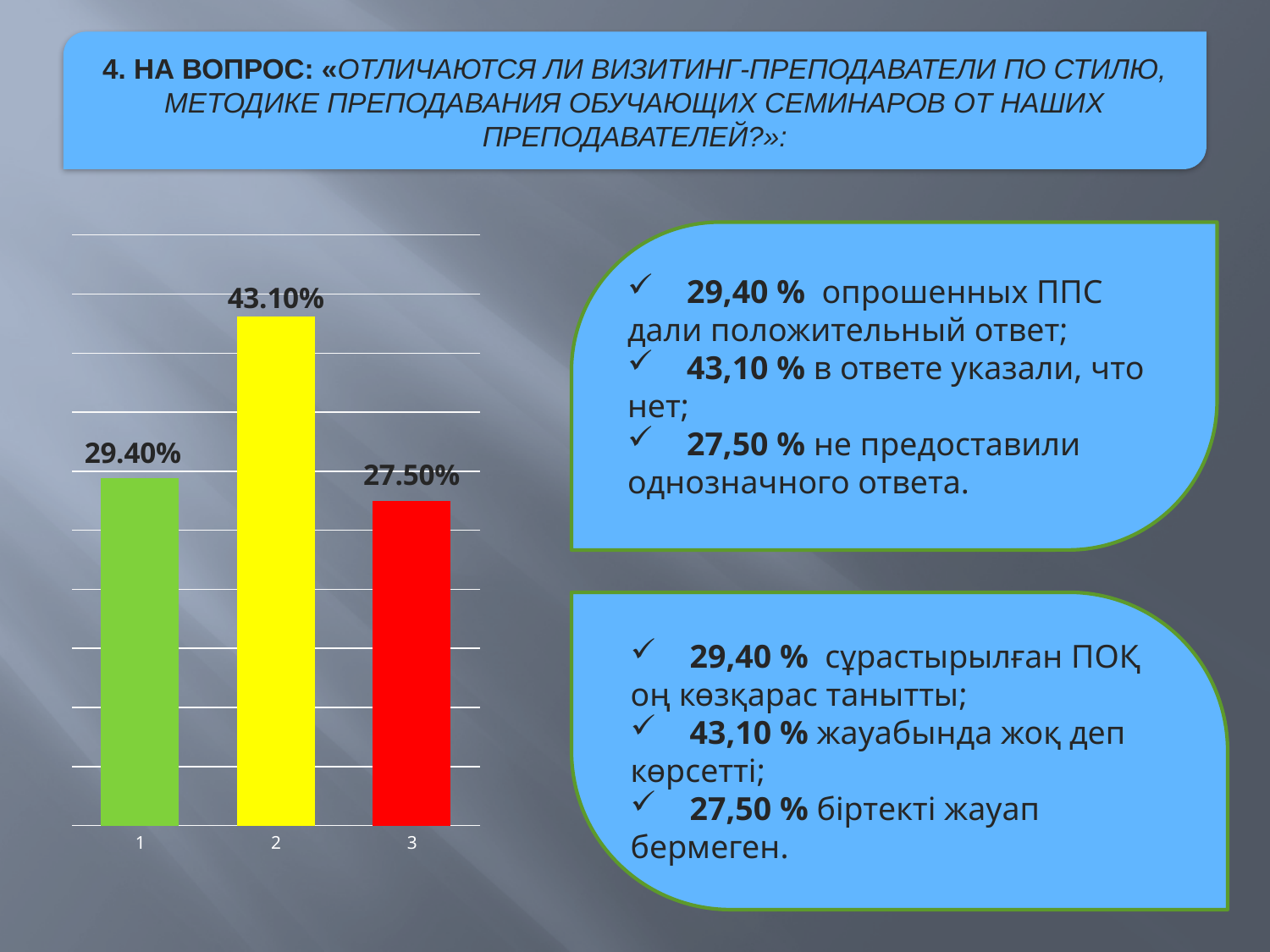
What is the value for category 1 in the bar chart? 29.40% How many bars are shown in the chart? 3 Which is larger, the value for category 1 or the value for category 3? category 1 Which is larger, the value for category 2 or the value for category 3? category 2 Which category has the lowest value in the bar chart? 3 Which category has the highest value in the bar chart? 2 What is the difference between the values for category 1 and category 3? 1.90% What is the value for category 2 in the bar chart? 43.10% What is the value for category 3 in the bar chart? 27.50% What is the difference between the values for category 2 and category 1? 13.70% What kind of chart is shown on the slide? bar chart What colour is the bar for category 2? yellow